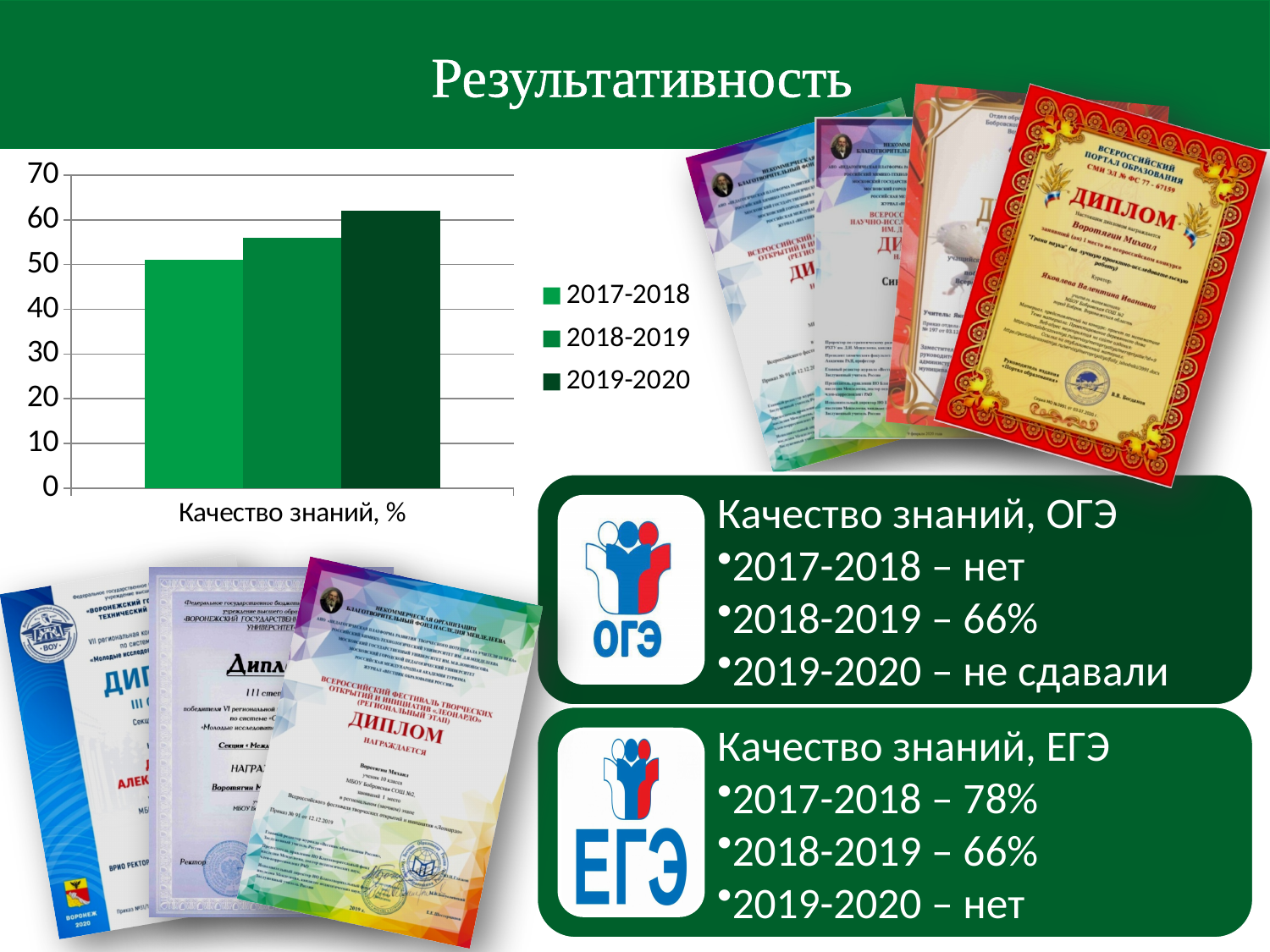
Is the value for 2017-2018 greater or less than 60? less Is the value for 2018-2019 greater or less than 50? greater Is the value for 2019-2020 greater or less than 60? greater Which series has the lowest bar in the chart? 2017-2018 Which is larger in the chart, the bar for 2018-2019 or the bar for 2019-2020? 2019-2020 What kind of chart is shown on the slide? bar chart How many categories are shown on the x axis of the chart? 1 Which series has the highest bar in the chart? 2019-2020 What is the category label shown under the bars of the chart? Качество знаний, % How many series does the chart legend list? 3 Do the bar values rise or fall from 2017-2018 to 2019-2020? rise Which is larger in the chart, the bar for 2017-2018 or the bar for 2019-2020? 2019-2020